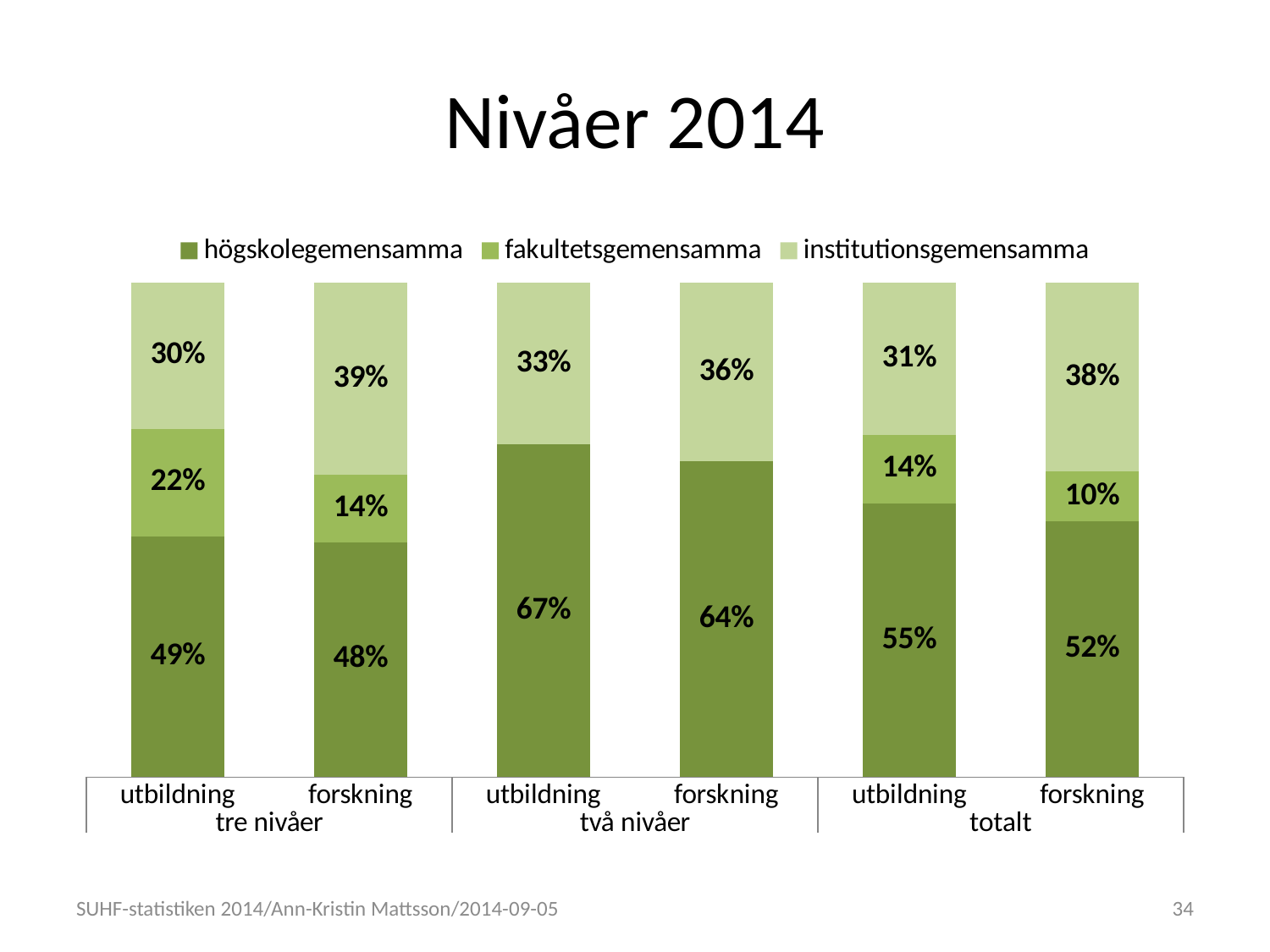
What kind of chart is shown on the slide? stacked bar chart What is the institutionsgemensamma value for forskning under tre nivåer? 39% What is the difference between the högskolegemensamma values for utbildning and forskning under totalt? 3% What is the högskolegemensamma value for utbildning under tre nivåer? 49% How many bars are shown in the chart? 6 What is the högskolegemensamma value for forskning under två nivåer? 64% What is the fakultetsgemensamma value for utbildning under totalt? 14% Which bar has the highest högskolegemensamma value? utbildning, två nivåer What is the title of the slide? Nivåer 2014 How many series does the legend list? 3 Which is larger: the institutionsgemensamma value for utbildning under två nivåer or for forskning under två nivåer? forskning under två nivåer Which bar has the lowest fakultetsgemensamma value among those labelled? forskning, totalt